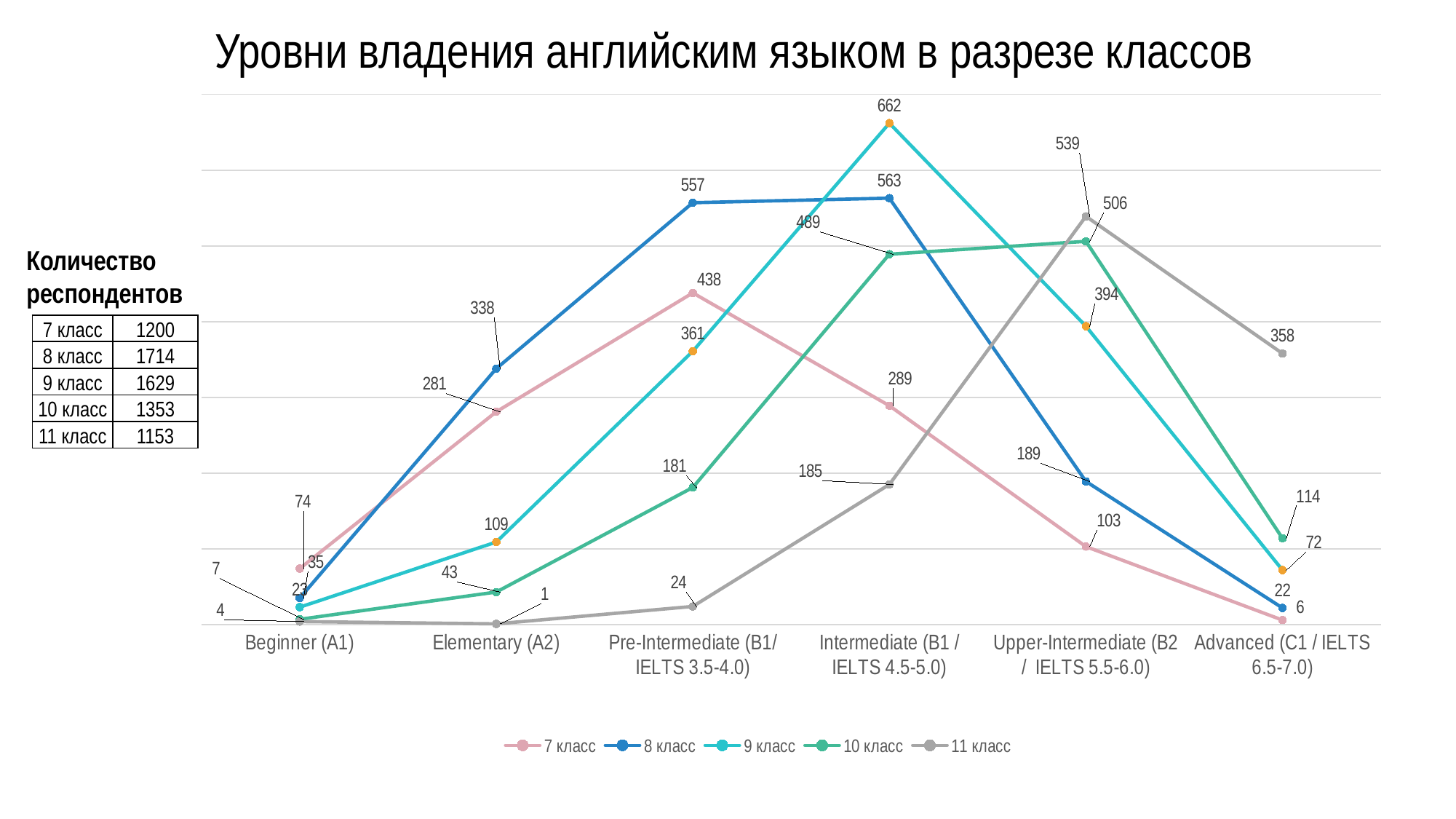
How many series does the legend list? 5 How many proficiency level categories are shown on the x axis? 6 Which series has the highest value at Beginner (A1)? 7 класс Do the values for 11 класс rise or fall from Pre-Intermediate (B1/ IELTS 3.5-4.0) to Upper-Intermediate (B2 / IELTS 5.5-6.0)? rise Which series has the lowest value at Elementary (A2)? 11 класс What type of chart is shown on the slide? line chart What is the value for 10 класс at Elementary (A2)? 43 What is the value for 9 класс at Intermediate (B1 / IELTS 4.5-5.0)? 662 What is the value for 8 класс at Pre-Intermediate (B1/ IELTS 3.5-4.0)? 557 What is the difference between the 8 класс values at Intermediate (B1 / IELTS 4.5-5.0) and Upper-Intermediate (B2 / IELTS 5.5-6.0)? 374 Which is larger at Upper-Intermediate (B2 / IELTS 5.5-6.0): the value for 10 класс or for 9 класс? 10 класс What is the value for 11 класс at Upper-Intermediate (B2 / IELTS 5.5-6.0)? 539